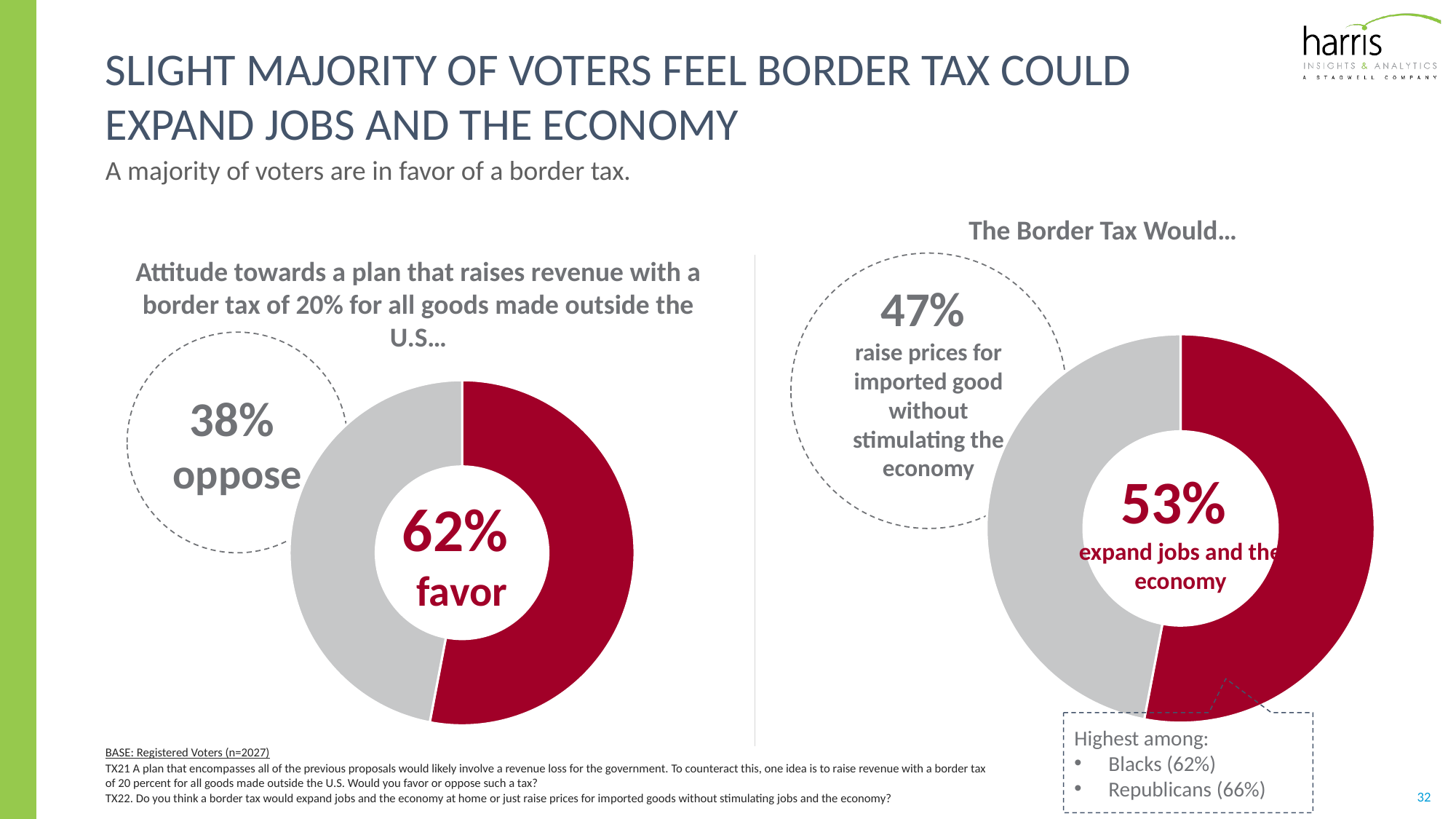
How many segments does the right chart titled 'The Border Tax Would...' have? 2 In the right chart titled 'The Border Tax Would...', what percentage say it would raise prices for imported goods without stimulating the economy? 47% In the right chart titled 'The Border Tax Would...', what is the difference in percentage points between the two responses? 6 What kind of chart is used on the left to show attitude towards the border tax plan? donut (pie) chart In the right chart titled 'The Border Tax Would...', which response has the smaller share? raise prices for imported good without stimulating the economy In the left chart on attitude towards the border tax plan, which response has the larger share: favor or oppose? favor In the left chart on attitude towards the border tax plan, what percentage of voters favor the plan? 62% According to the callout box on the right chart, what percentage of Republicans say the border tax would expand jobs and the economy? 66% In the left chart on attitude towards the border tax plan, what colour is the 'favor' segment? red In the left chart on attitude towards the border tax plan, what percentage of voters oppose the plan? 38% In the left chart on attitude towards the border tax plan, what is the difference in percentage points between favor and oppose? 24 In the right chart titled 'The Border Tax Would...', what percentage say it would expand jobs and the economy? 53%